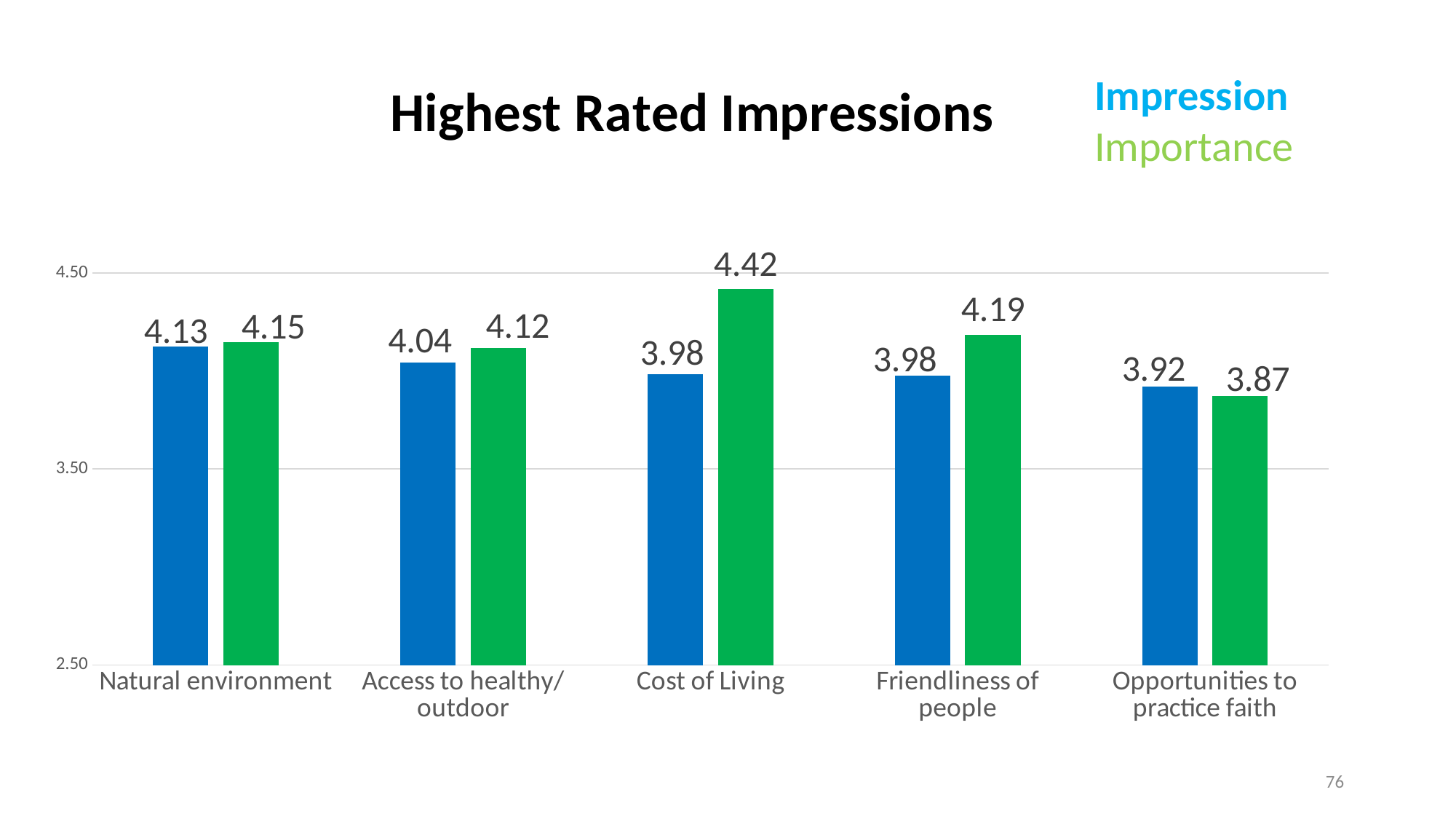
What is the Importance value for Cost of Living? 4.42 What kind of chart is shown on the slide? Bar chart For Friendliness of people, which is larger: the Impression value or the Importance value? Importance How many categories are shown on the x axis? 5 What is the Impression value for Natural environment? 4.13 What is the difference between the Importance and Impression values for Cost of Living? 0.44 What is the Impression value for Cost of Living? 3.98 Which category has the lowest Impression value? Opportunities to practice faith What is the title of the chart? Highest Rated Impressions How many series does the legend list? 2 Which category has the highest Importance value? Cost of Living What is the Importance value for Opportunities to practice faith? 3.87